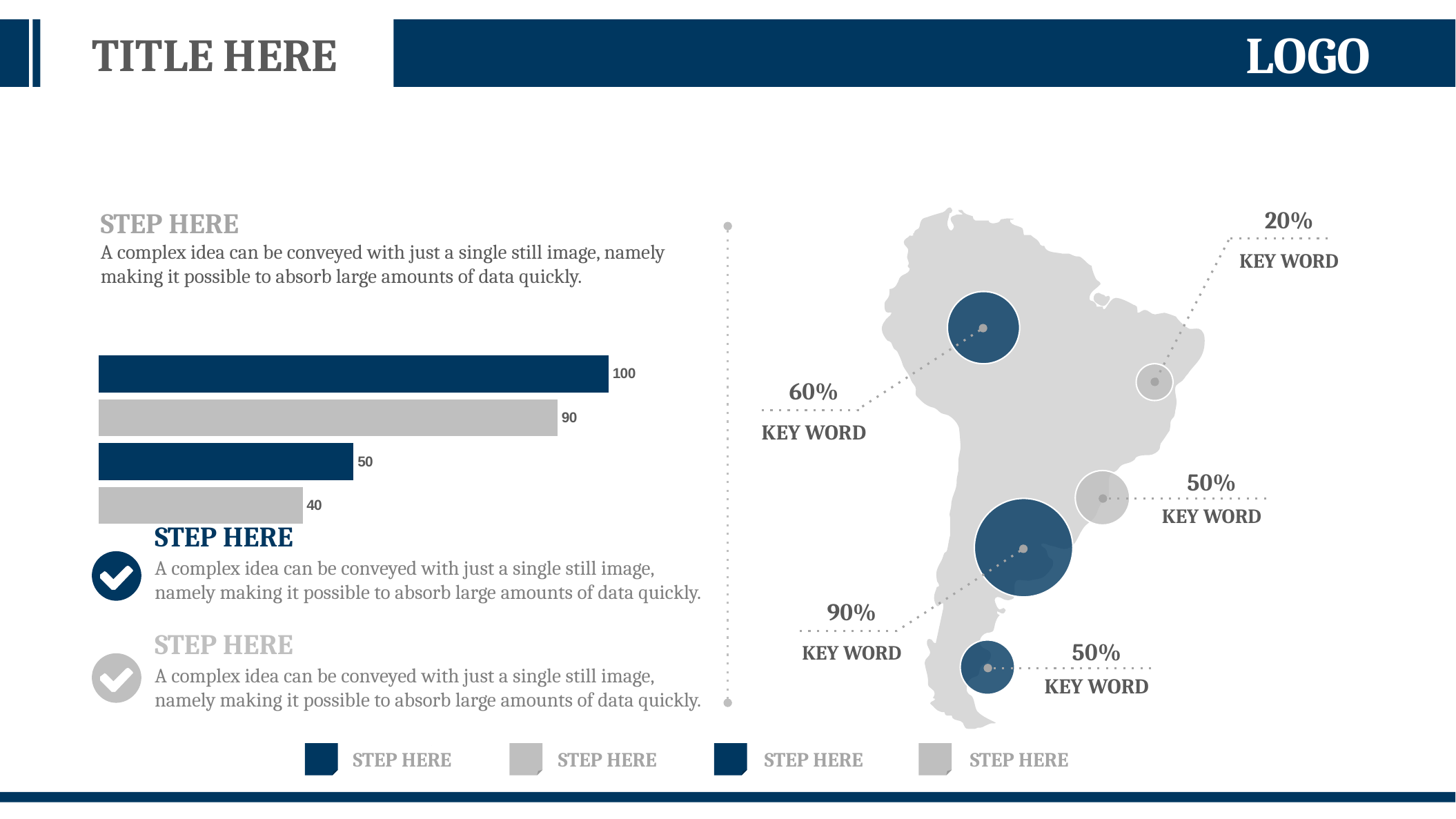
Do the bar values increase or decrease going from the top bar to the bottom bar? decrease What is the value of the bottom bar in the bar chart? 40 In the bar chart, which is larger: the second bar from the top or the third bar from the top? the second bar from the top How many bars does the bar chart on the left contain? 4 What is the difference between the top bar and the bottom bar in the bar chart? 60 What is the highest value shown in the bar chart? 100 What is the value of the second bar from the top in the bar chart? 90 What is the lowest value shown in the bar chart? 40 What colour is the top bar in the bar chart? dark blue What is the value of the third bar from the top in the bar chart? 50 What kind of chart is shown on the left side of the slide? bar chart What is the value of the top bar in the bar chart? 100